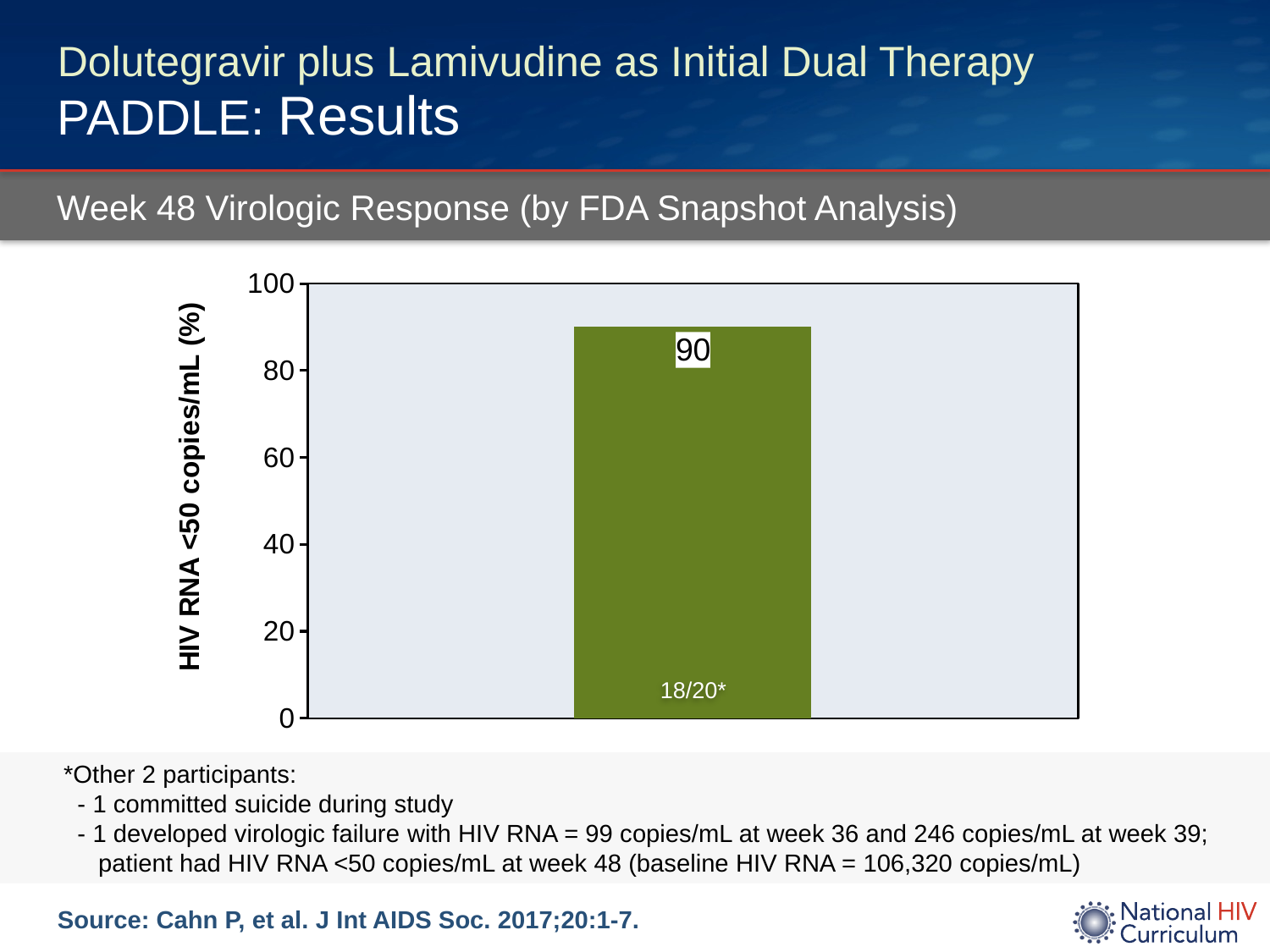
Is the value of the bar greater or less than 100? less What kind of chart is shown on the slide? bar chart Is the value of the bar greater or less than 80? greater What is the title of the chart? Week 48 Virologic Response (by FDA Snapshot Analysis) What is the maximum value shown on the y-axis? 100 What is the label of the y-axis? HIV RNA <50 copies/mL (%) What fraction of participants is printed inside the bar? 18/20* How many bars are plotted in the chart? 1 What is the value shown on the bar in the chart? 90